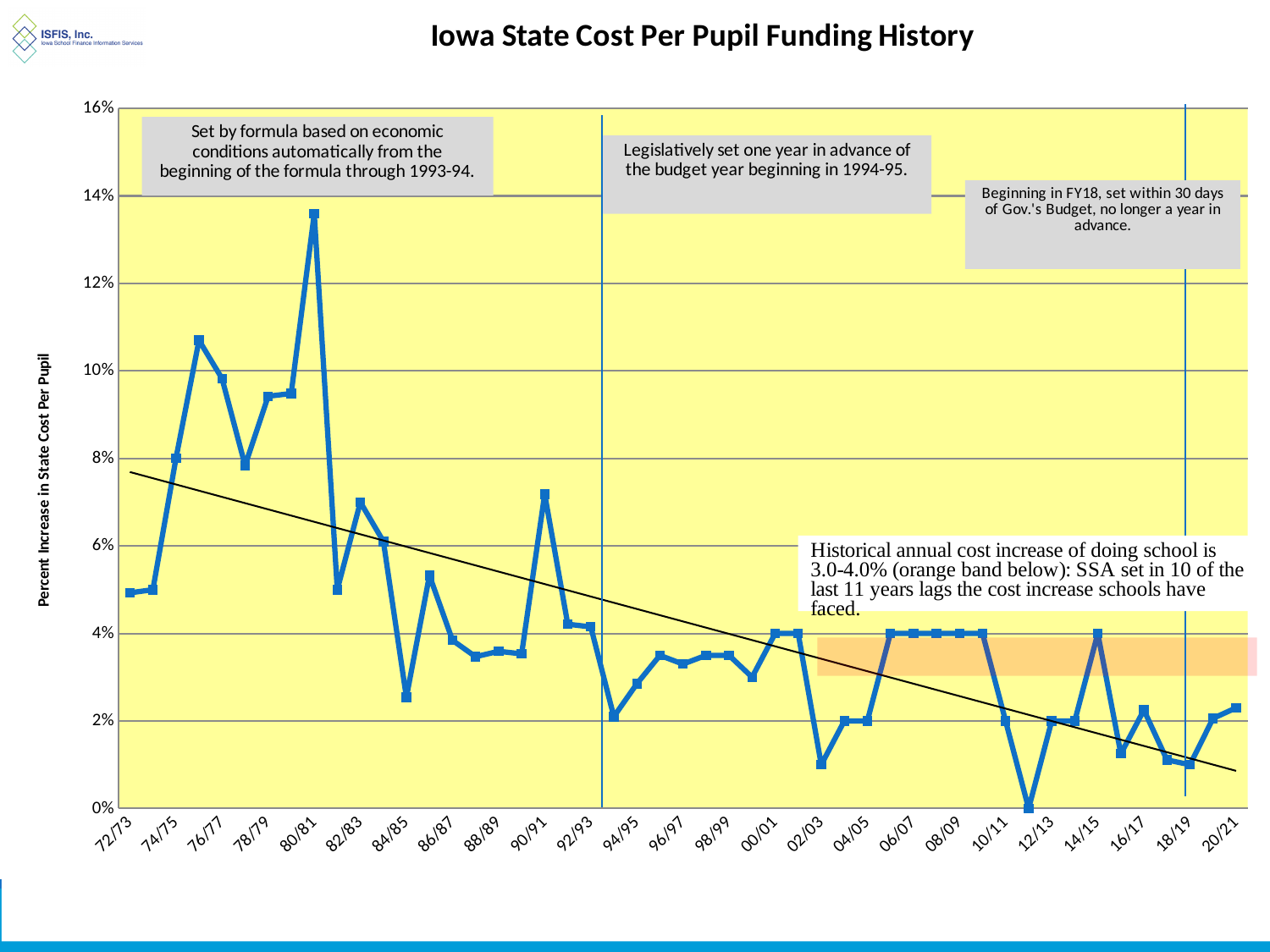
What kind of chart is shown on the slide? line chart What is the label on the vertical axis of the chart? Percent Increase in State Cost Per Pupil What is the percent increase in state cost per pupil for 00/01? 4% Which year has the larger percent increase, 80/81 or 90/91? 80/81 What is the title of the chart? Iowa State Cost Per Pupil Funding History Is the value for 84/85 greater or less than 4%? less What is the percent increase in state cost per pupil for 14/15? 4% What is the percent increase in state cost per pupil for 10/11? 2% Overall, do the percent increases rise or fall from 72/73 to 20/21? fall Which year has the highest percent increase in state cost per pupil? 80/81 Is the value for 80/81 greater or less than 12%? greater What is the percent increase in state cost per pupil for 74/75? 8%